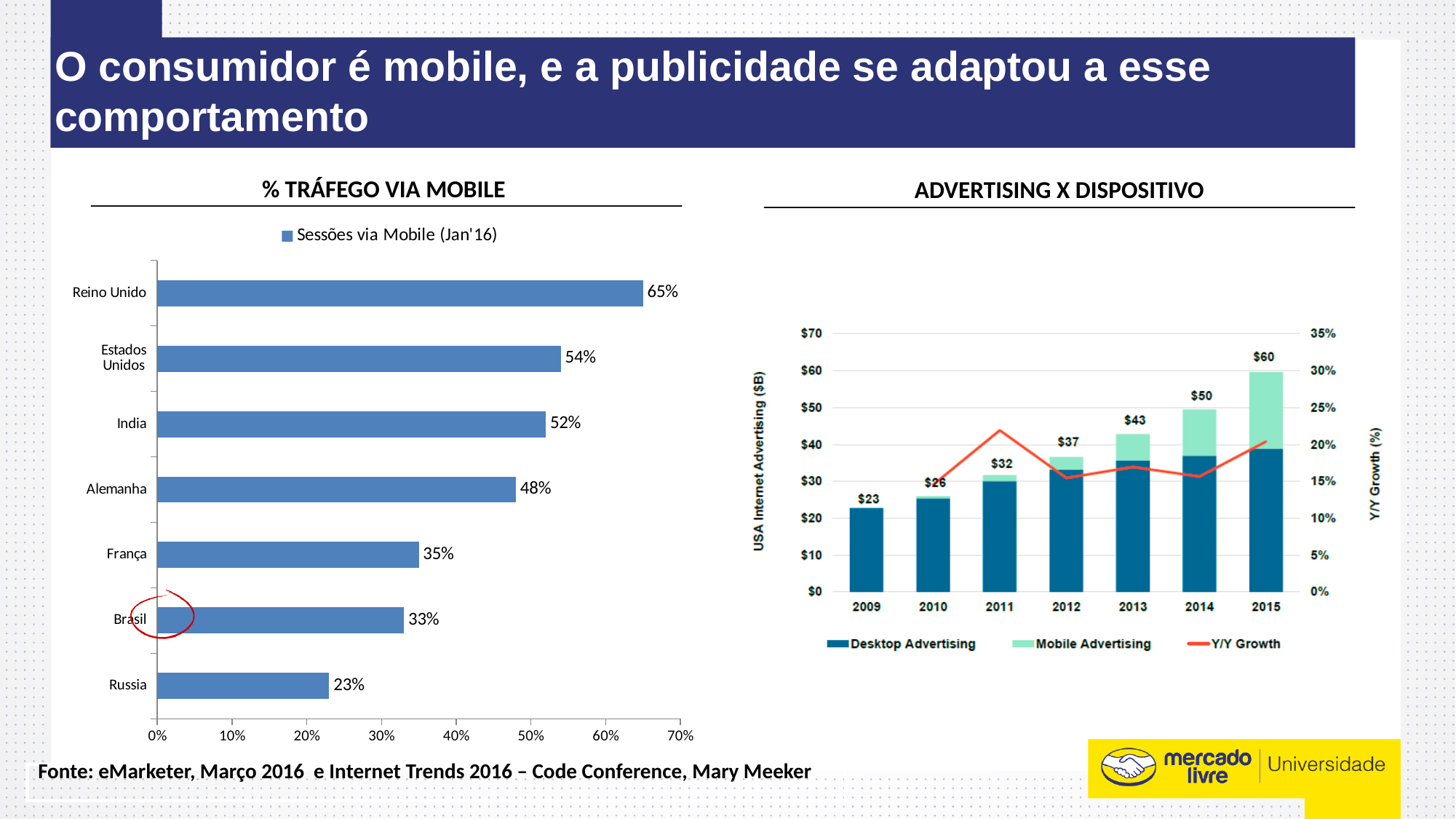
In the 'ADVERTISING X DISPOSITIVO' chart, how many series does the legend list? 3 In the '% TRÁFEGO VIA MOBILE' chart, what is the difference between Estados Unidos and Alemanha? 6% In the '% TRÁFEGO VIA MOBILE' chart, which country has the lowest value? Russia In the 'ADVERTISING X DISPOSITIVO' chart, do the total advertising values rise or fall from 2009 to 2015? Rise What kind of chart is the '% TRÁFEGO VIA MOBILE' chart? Bar chart In the 'ADVERTISING X DISPOSITIVO' chart, what is the difference between the total for 2014 and the total for 2013? $7 In the '% TRÁFEGO VIA MOBILE' chart, what is the value for Reino Unido? 65% In the '% TRÁFEGO VIA MOBILE' chart, how many countries are shown? 7 In the 'ADVERTISING X DISPOSITIVO' chart, what is the total USA Internet Advertising value for 2015? $60 In the '% TRÁFEGO VIA MOBILE' chart, what is the value for Brasil? 33% In the '% TRÁFEGO VIA MOBILE' chart, which country has the highest value? Reino Unido In the '% TRÁFEGO VIA MOBILE' chart, which is larger, India or França? India